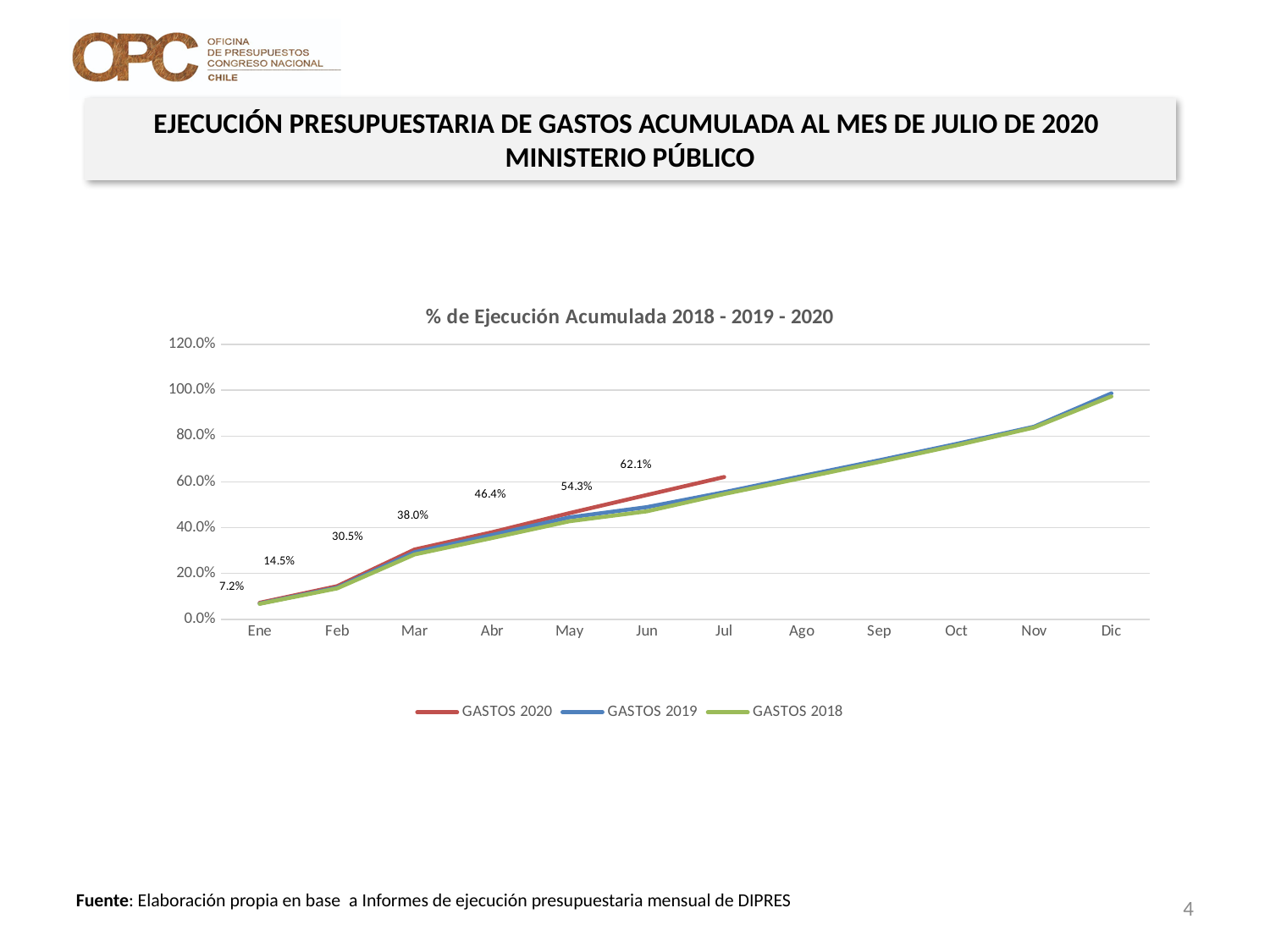
What is the difference between the GASTOS 2020 values for Jul and Jun? 7.8% In which month does the GASTOS 2020 series reach its highest value? Jul What type of chart is shown on the slide? Line chart What is the value for GASTOS 2020 in Ene? 7.2% How many months are shown on the x axis? 12 Is the value for GASTOS 2019 in Dic greater or less than 80.0%? greater What is the value for GASTOS 2020 in Jul? 62.1% In which month is the GASTOS 2020 value lowest? Ene How many series does the legend list? 3 What is the value for GASTOS 2020 in May? 46.4% What is the value for GASTOS 2020 in Mar? 30.5% Do the values of the GASTOS 2018 series rise or fall from Ene to Dic? Rise